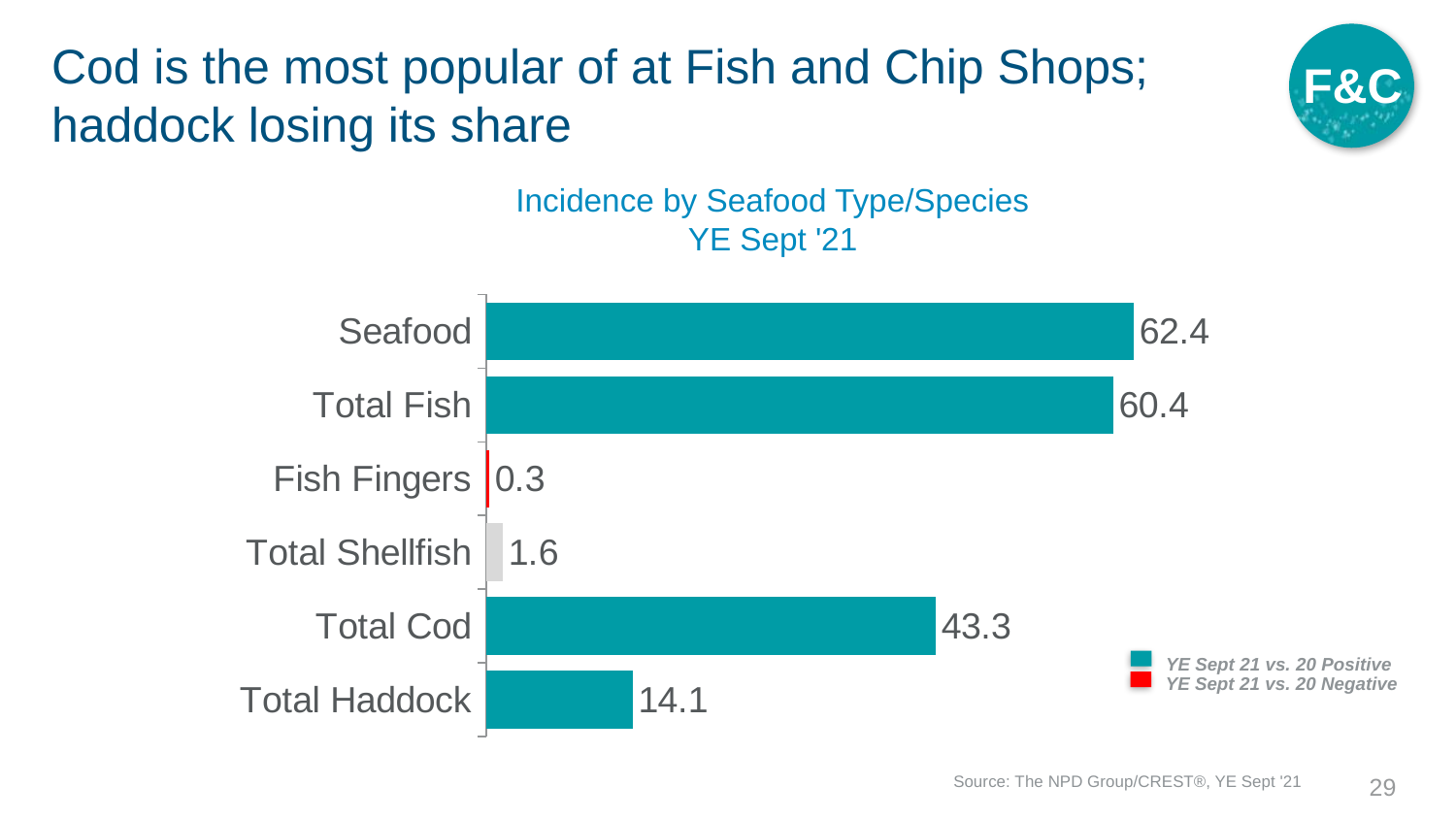
Which category has the lowest value? Fish Fingers What is the difference between the values for Total Cod and Total Haddock? 29.2 What kind of chart is shown on the slide? Bar chart Which category has the highest value? Seafood What is the value for Total Shellfish? 1.6 What is the value for Seafood? 62.4 How many categories are shown in the chart? 6 What is the title of the chart? Incidence by Seafood Type/Species YE Sept '21 What is the value for Total Haddock? 14.1 Which is larger, the value for Total Cod or the value for Total Haddock? Total Cod What is the value for Fish Fingers? 0.3 What is the difference between the values for Seafood and Total Fish? 2.0